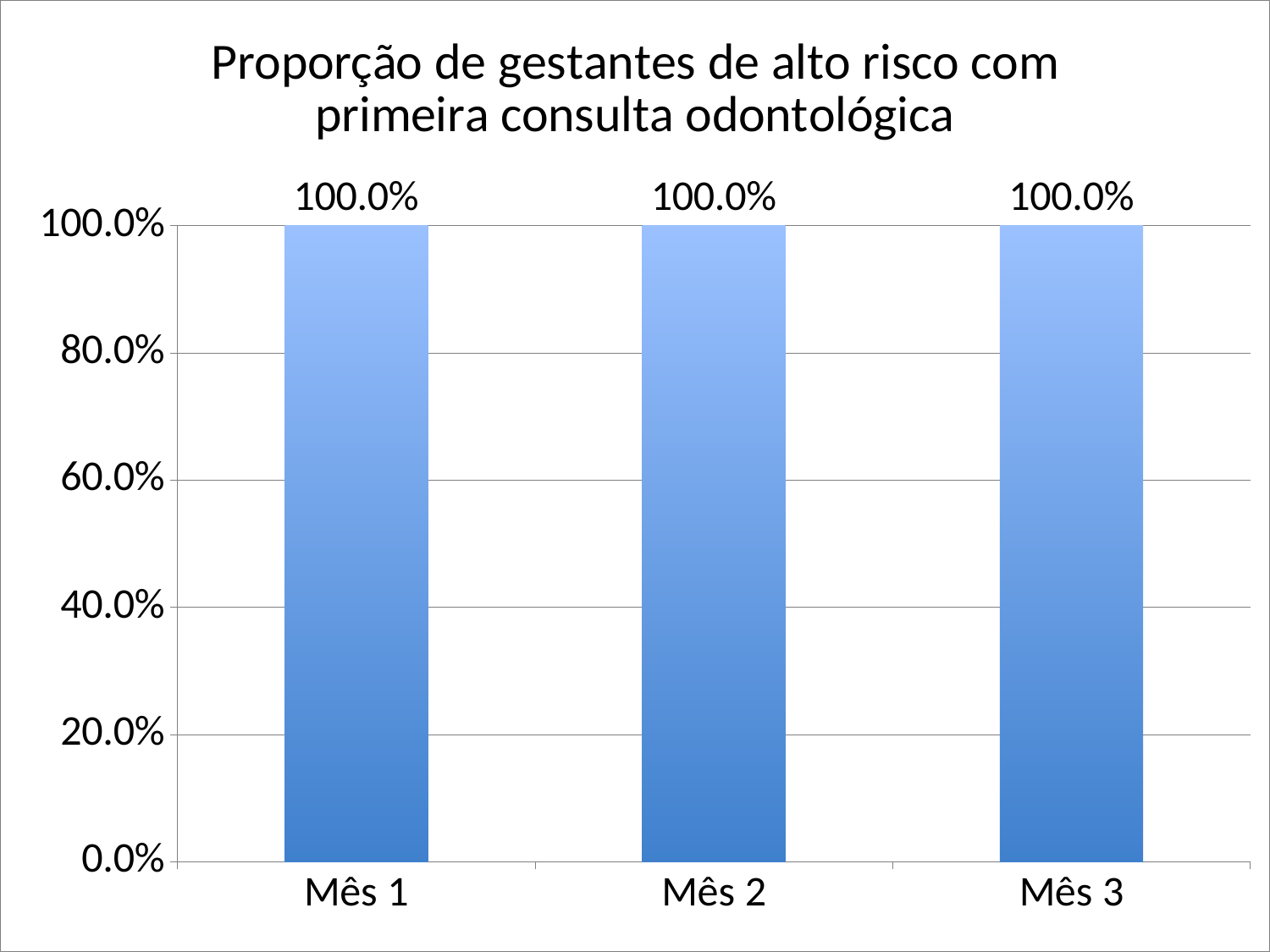
What is the highest value shown on the y axis? 100.0% Is the value for Mês 2 greater or less than 80.0%? greater What is the value for Mês 1? 100.0% What is the value for Mês 3? 100.0% What kind of chart is shown on the slide? bar chart What is the title of the chart? Proporção de gestantes de alto risco com primeira consulta odontológica How many categories are shown on the x axis? 3 Do the values rise, fall or stay the same from Mês 1 to Mês 3? stay the same What is the value for Mês 2? 100.0% What is the difference between the values for Mês 1 and Mês 3? 0.0%